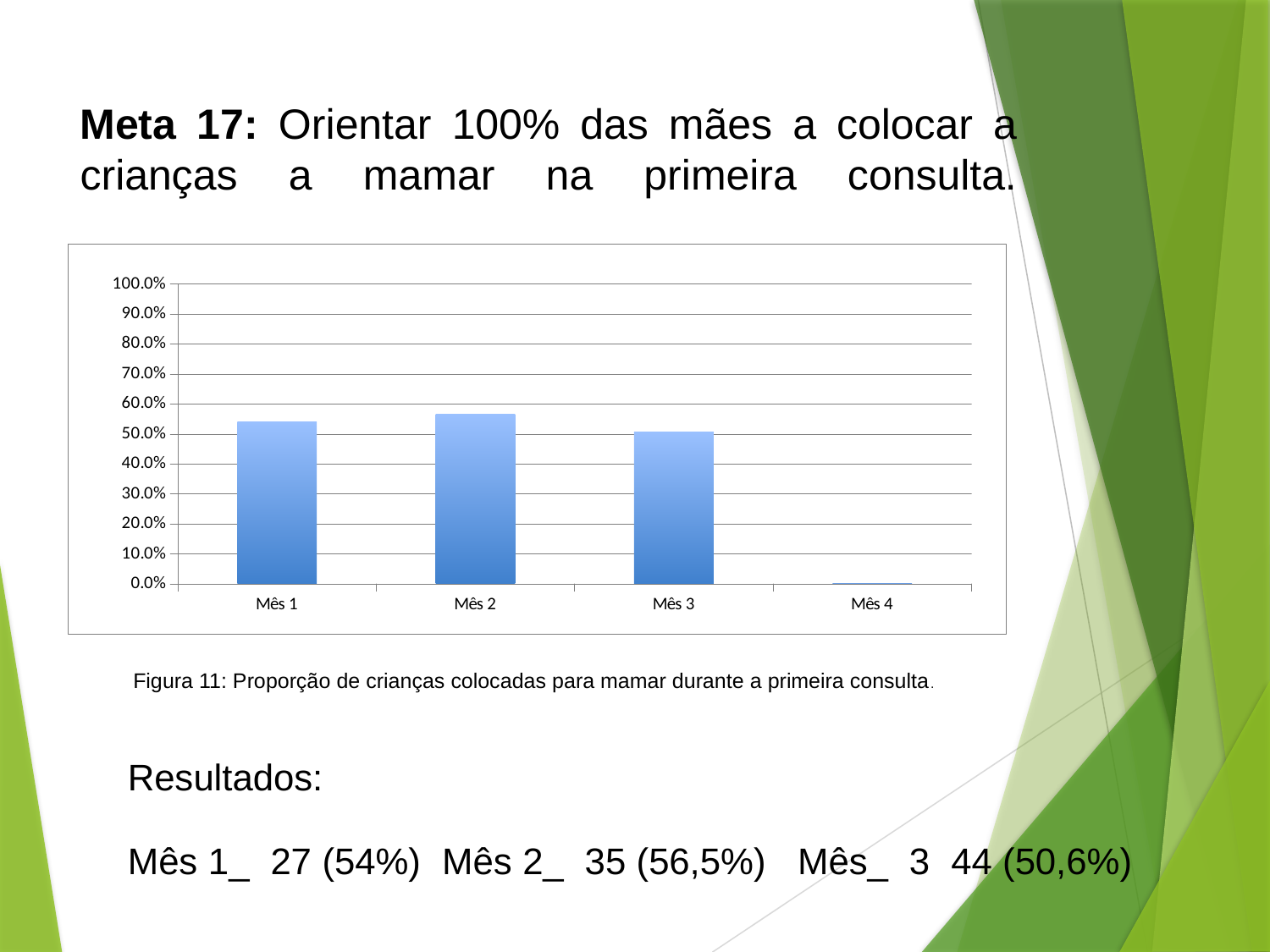
Is the value for Mês 3 greater or less than 60.0%? less How many categories (months) are shown on the x axis of the chart? 4 According to the results text on the slide, what proportion is reported for Mês 2? 56,5% Which month has the highest bar in the chart? Mês 2 Which month has the lowest value in the chart? Mês 4 Is the value for Mês 1 greater or less than 50.0%? greater Do the values rise or fall from Mês 2 to Mês 3? fall According to the results text on the slide, what proportion is reported for Mês 3? 50,6% Which is larger, the value for Mês 1 or the value for Mês 3? Mês 1 What is the figure caption given below the chart? Figura 11: Proporção de crianças colocadas para mamar durante a primeira consulta. What kind of chart is shown on the slide? bar chart Is the value for Mês 2 greater or less than 70.0%? less